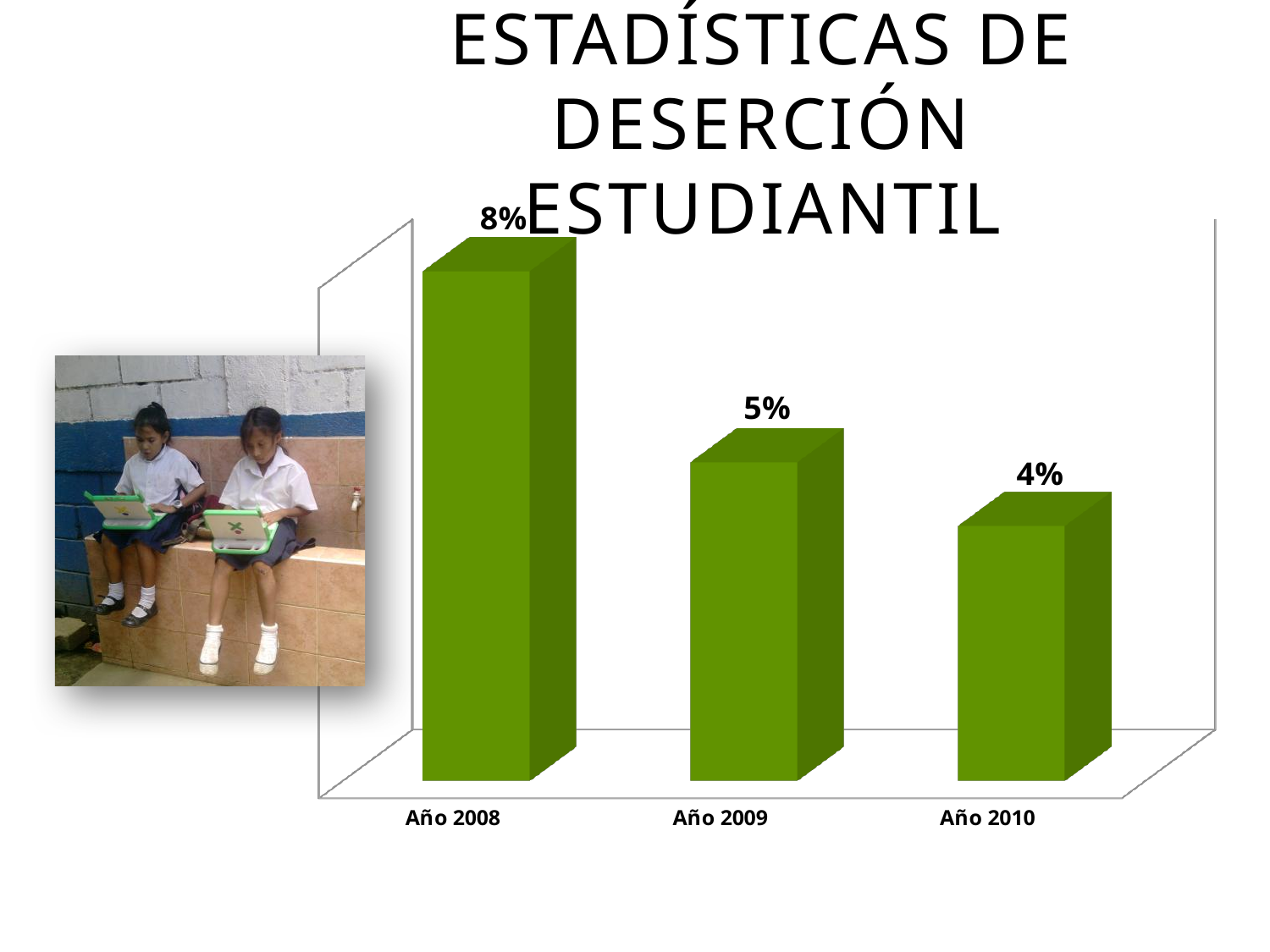
What kind of chart is shown on the slide? Bar chart What is the value for Año 2008? 8% Do the values rise or fall from Año 2008 to Año 2010? Fall What is the value for Año 2009? 5% What is the value for Año 2010? 4% Which year has the lowest value? Año 2010 What is the difference between the values for Año 2008 and Año 2010? 4% What is the title of the slide containing the chart? ESTADÍSTICAS DE DESERCIÓN ESTUDIANTIL Which year has the highest value? Año 2008 Which is larger, the value for Año 2009 or Año 2010? Año 2009 What is the difference between the values for Año 2008 and Año 2009? 3% How many years are shown in the chart? 3